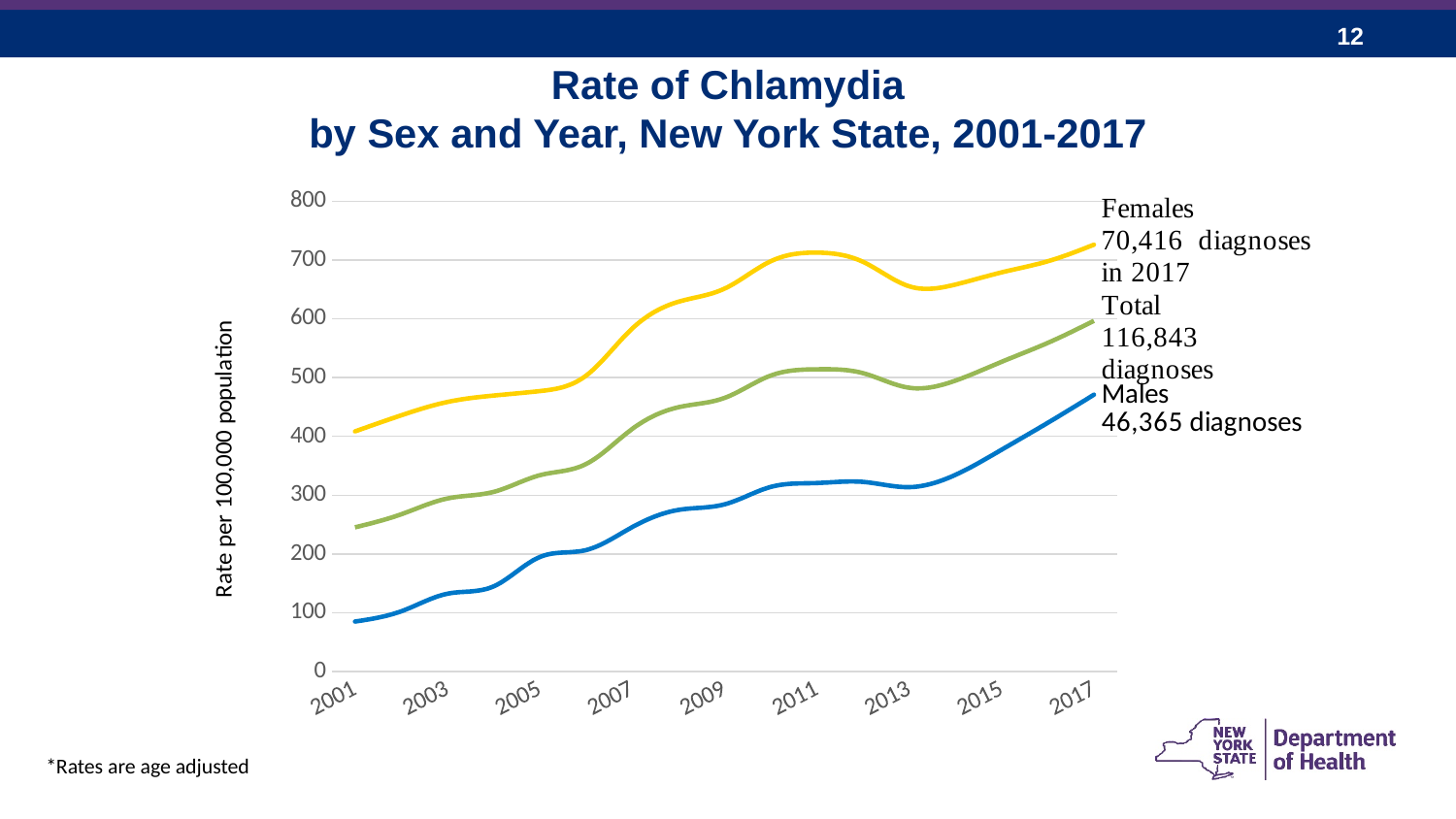
How many diagnoses among females in 2017 are noted on the chart? 70,416 What is the title of the chart on the slide? Rate of Chlamydia by Sex and Year, New York State, 2001-2017 Which series has the higher rate in 2017, Females or Males? Females What is the label on the vertical axis of the chart? Rate per 100,000 population Is the rate for Males in 2001 greater or less than 100? less Does the rate for Males generally rise or fall from 2001 to 2017? rise What total number of diagnoses is noted on the chart? 116,843 How many diagnoses among males are noted on the chart? 46,365 How many lines (series) are plotted on the chart? 3 Is the rate for Females in 2017 greater or less than 700? greater Is the rate for Males in 2017 greater or less than 500? less What kind of chart is shown on the slide? line chart